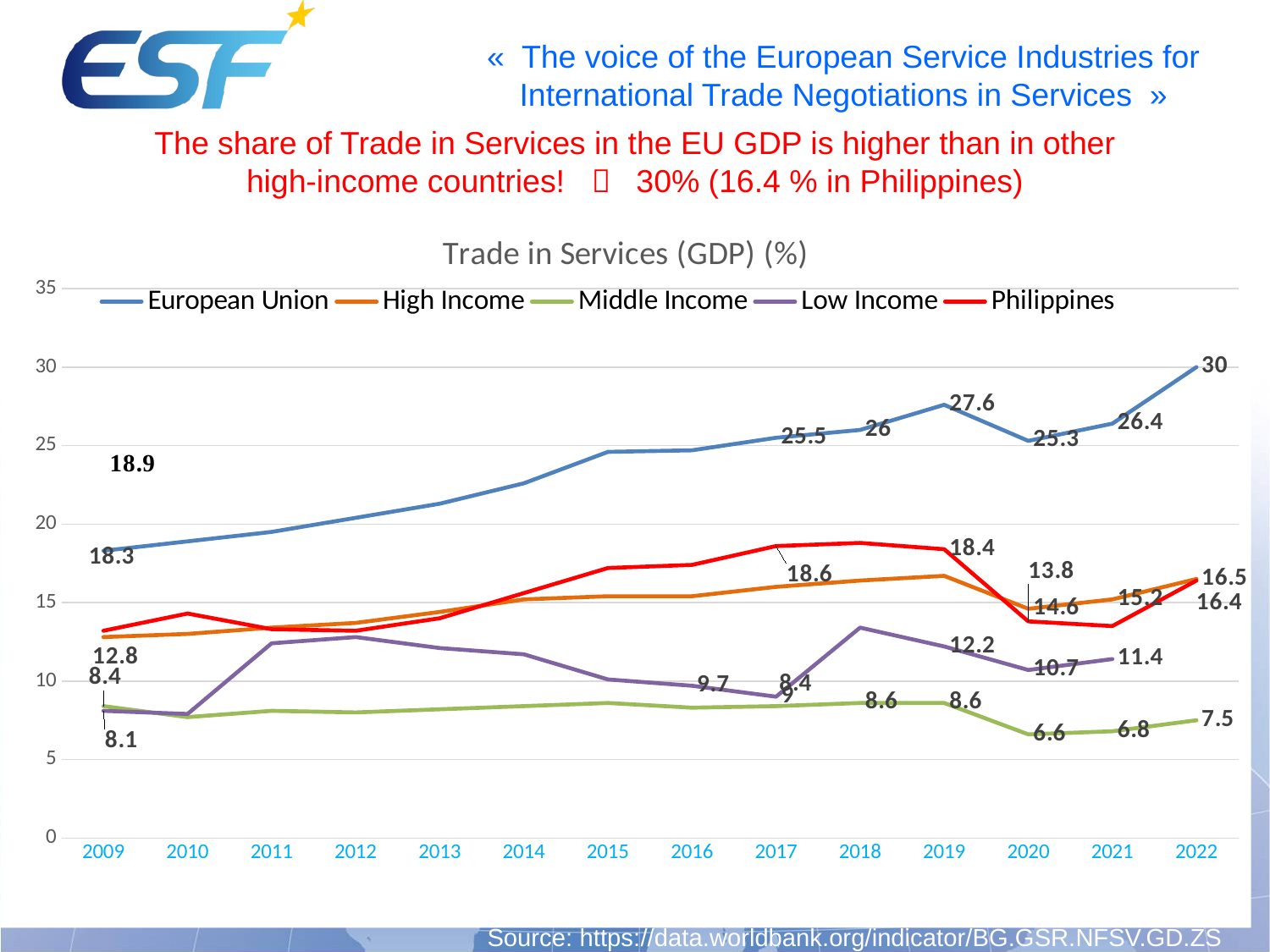
How many series does the legend of the chart list? 5 What is the value for the European Union in 2022? 30 Which series has the highest value in 2022? European Union What is the value for Low Income in 2021? 11.4 What is the value for Middle Income in 2020? 6.6 What is the difference between the European Union values in 2022 and 2009? 11.7 Is the value for Low Income in 2011 greater or less than 10? greater What is the title of the chart? Trade in Services (GDP) (%) How many years are shown on the x axis of the chart? 14 What is the value for the European Union in 2019? 27.6 Which year has the larger European Union value, 2019 or 2021? 2019 What kind of chart is shown on the slide? line chart